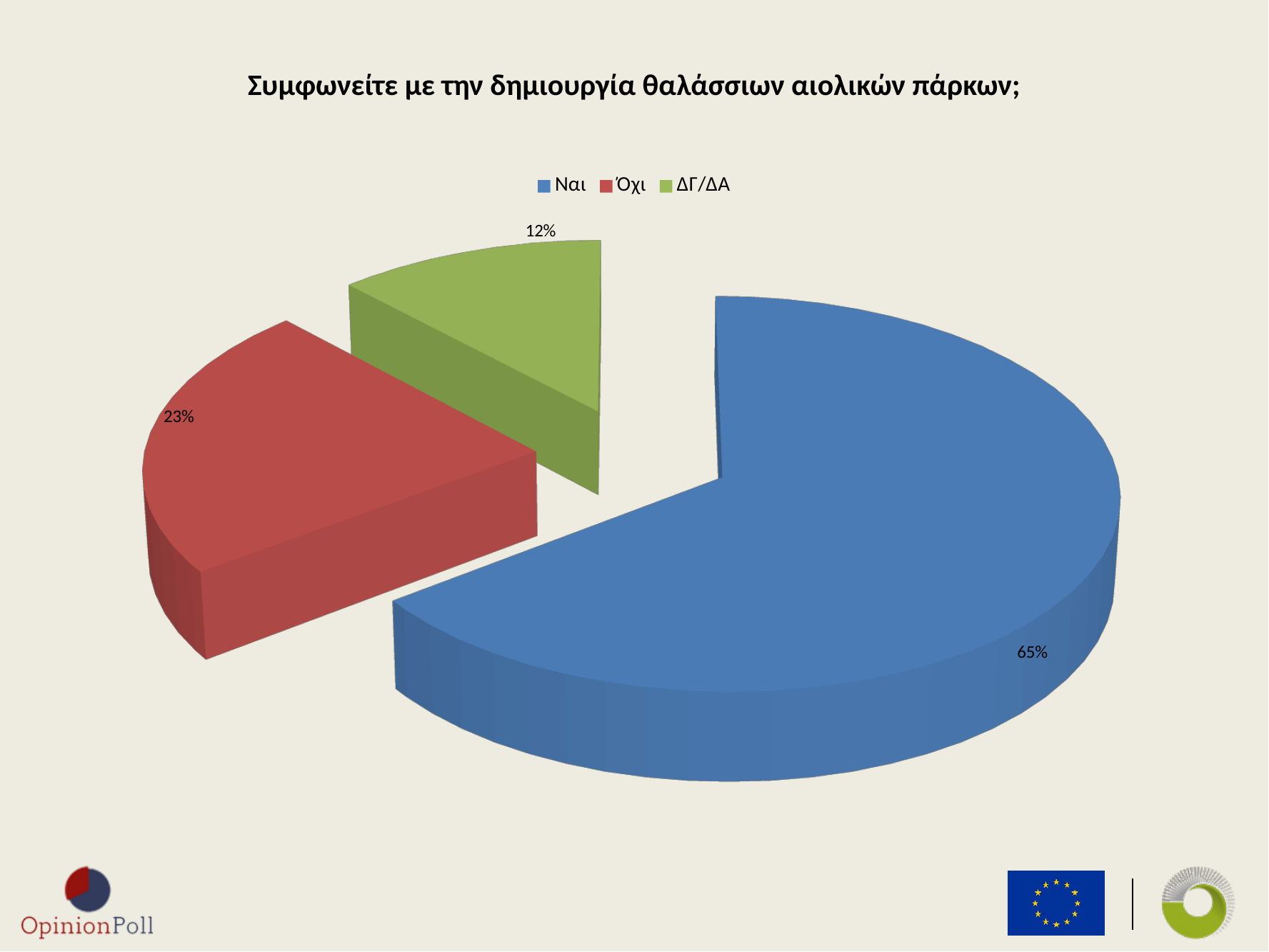
What kind of chart is shown on the slide? Pie chart Which response has the largest share of the pie? Ναι Which response has the smallest share of the pie? ΔΓ/ΔΑ What percentage of respondents answered ΔΓ/ΔΑ? 12% What percentage of respondents answered Όχι? 23% Which is larger, the share for Όχι or the share for ΔΓ/ΔΑ? Όχι What percentage of respondents answered Ναι? 65% What is the difference in percentage points between Ναι and Όχι? 42 What colour is the slice for Όχι? Red How many slices does the pie chart have? 3 How many entries does the legend list? 3 What is the difference in percentage points between Όχι and ΔΓ/ΔΑ? 11